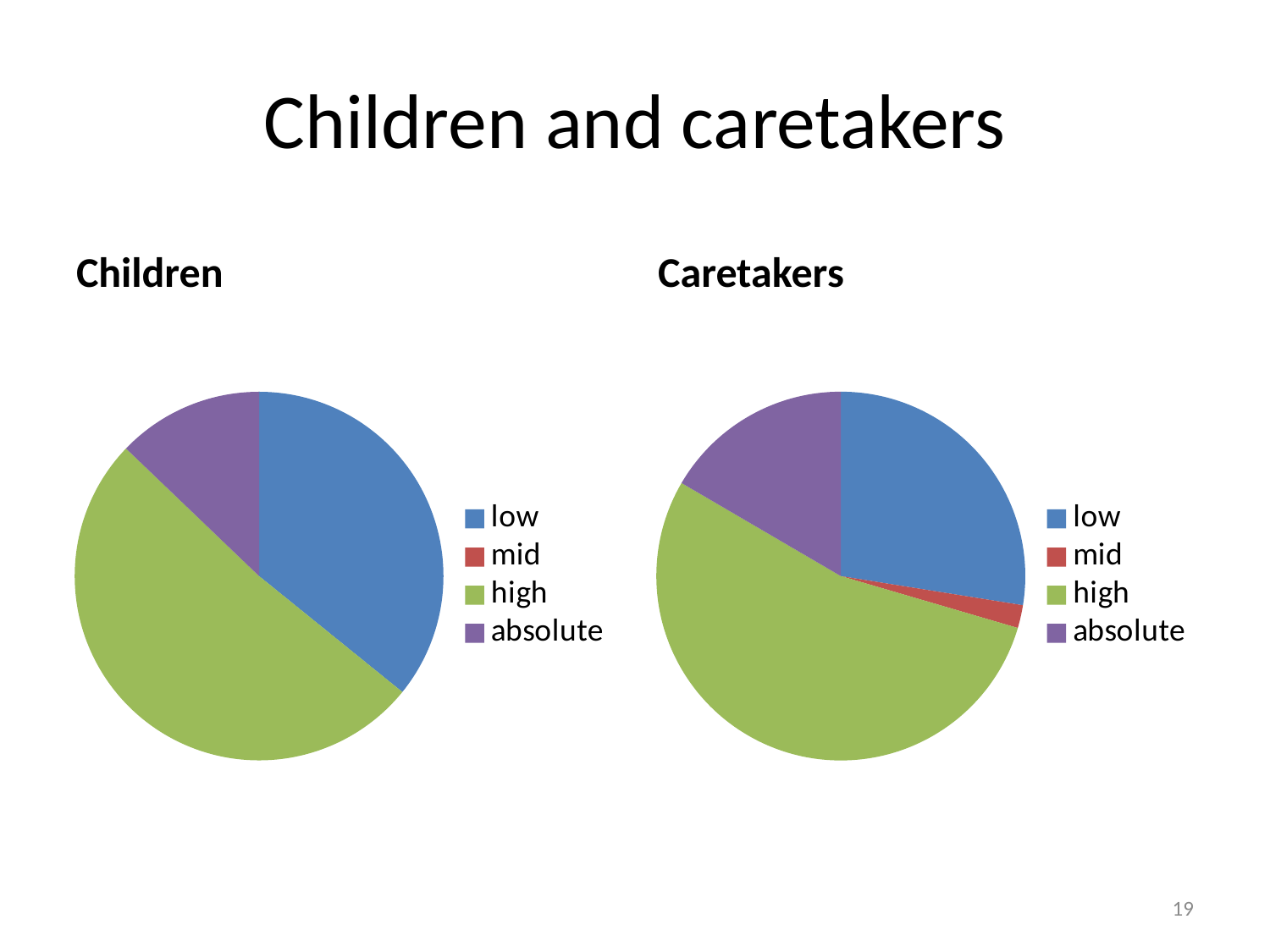
How many categories does the legend of the Caretakers chart list? 4 What kind of chart is the Children chart? pie chart In the Children chart, which colour represents the high category? green In the Caretakers chart, which slice is larger, high or low? high In the Children chart, which category has the largest slice? high In the Children chart, which slice is larger, low or absolute? low What kind of chart is the Caretakers chart? pie chart In the Caretakers chart, which category has the smallest slice? mid In the Caretakers chart, which slice is larger, low or absolute? low How many categories does the legend of the Children chart list? 4 In the Caretakers chart, which category has the largest slice? high How many pie charts are shown on the slide? 2